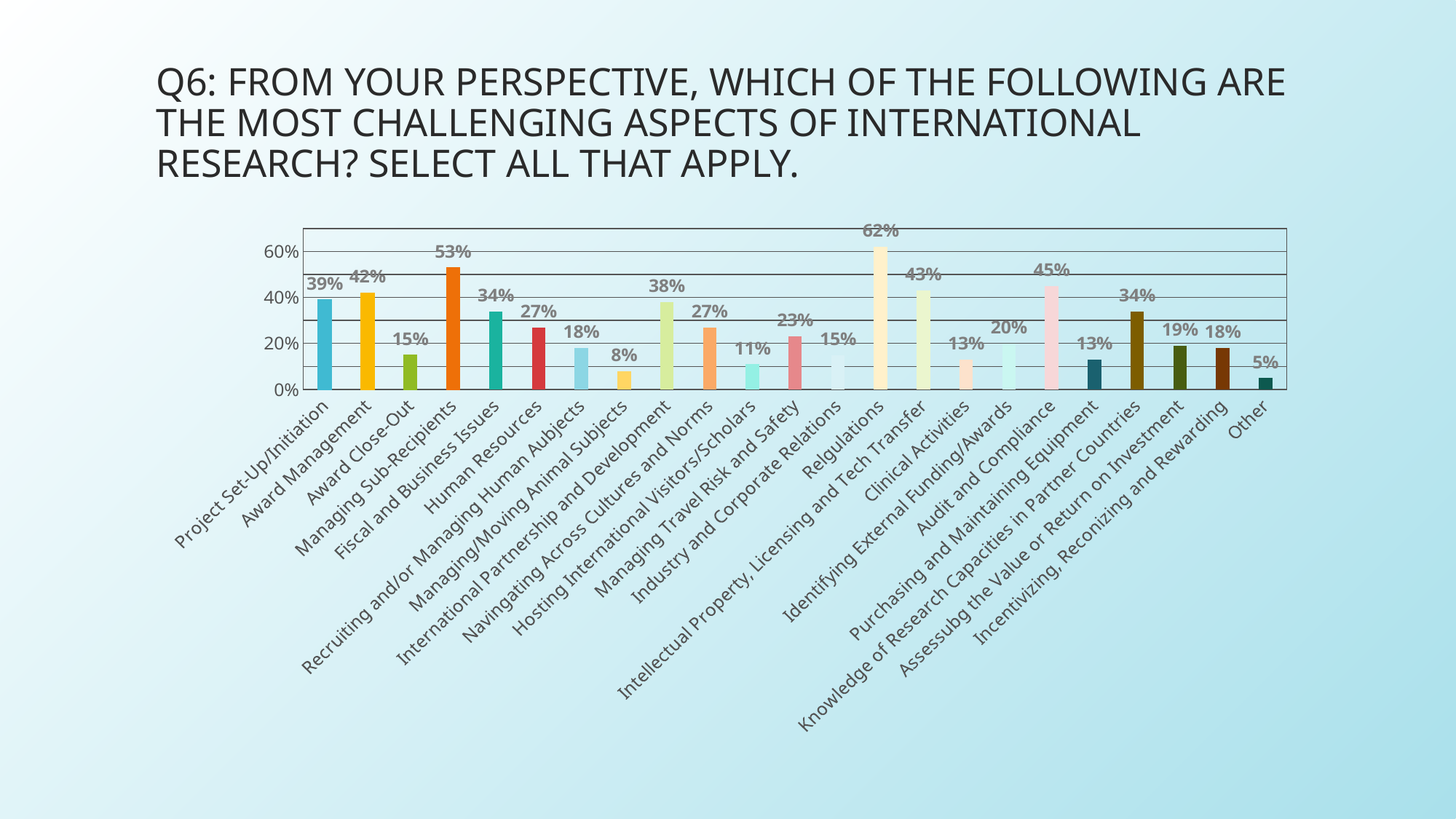
What is the highest value labelled on the vertical axis? 60% How many categories are shown in the chart? 23 What is the difference between the values for Relgulations and Managing Sub-Recipients? 9% What kind of chart is shown on the slide? Bar chart What is the value for Hosting International Visitors/Scholars? 11% Which is larger, the value for International Partnership and Development or the value for Intellectual Property, Licensing and Tech Transfer? Intellectual Property, Licensing and Tech Transfer What is the value for Managing Travel Risk and Safety? 23% Which category has the highest value? Relgulations Which category has the lowest value? Other What is the value for Managing Sub-Recipients? 53% What is the difference between the values for Award Management and Award Close-Out? 27% What is the value for Audit and Compliance? 45%